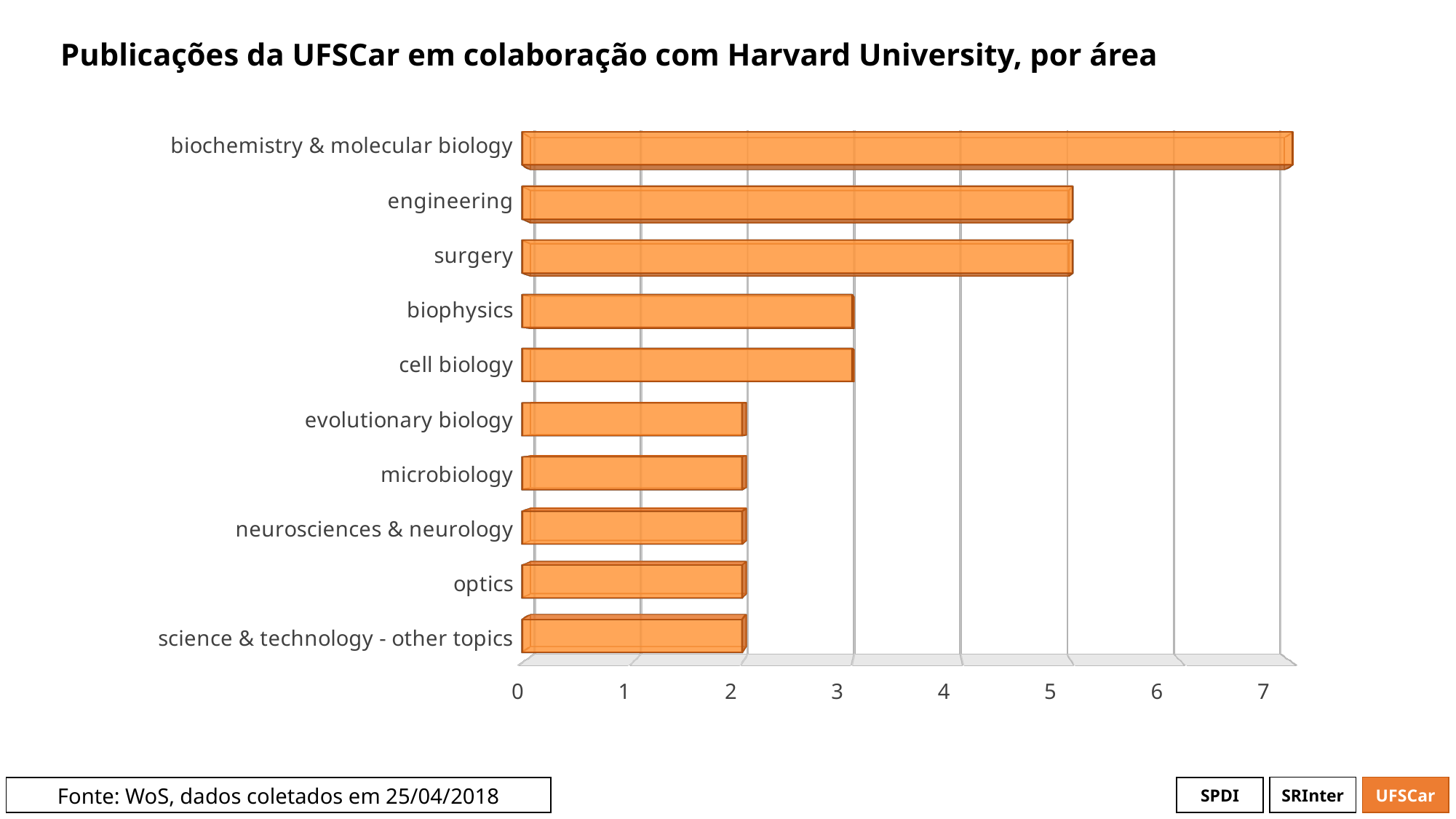
How many areas (categories) are shown in the chart? 10 How many publications are shown for optics? 2 Is the value for biochemistry & molecular biology greater or less than 6? greater What is the title of the chart? Publicações da UFSCar em colaboração com Harvard University, por área Which has more publications, microbiology or cell biology? cell biology Is the value for surgery greater or less than 4? greater How many publications are shown for biophysics? 3 Which area has the highest number of publications? biochemistry & molecular biology Which has more publications, engineering or biophysics? engineering Is the value for cell biology greater or less than 4? less How many publications are shown for engineering? 5 What kind of chart is shown on the slide? bar chart